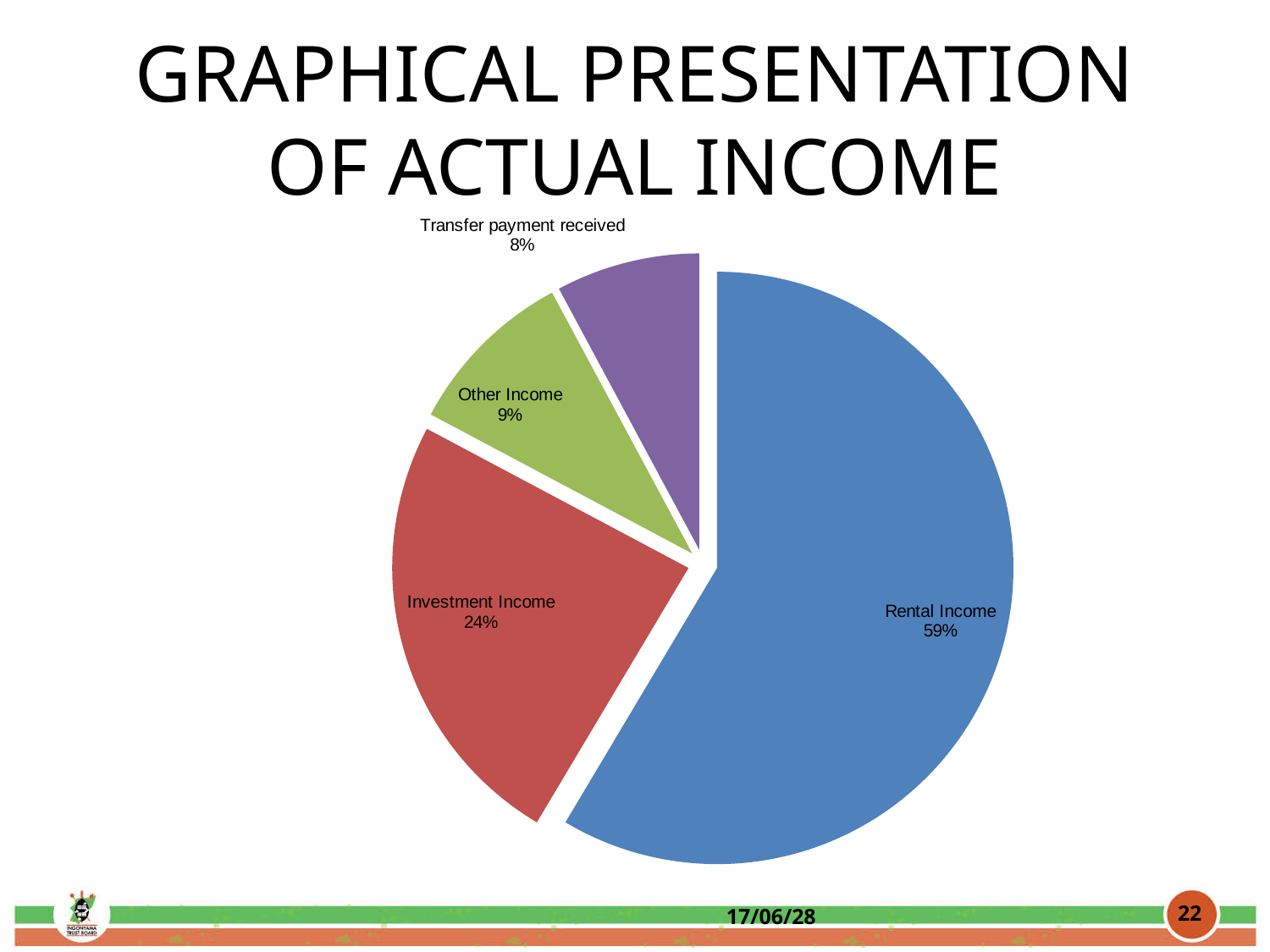
What kind of chart is shown on the slide? Pie chart Which is larger, Investment Income or Other Income? Investment Income What is the difference in percentage points between Rental Income and Investment Income? 35 What share of actual income does Rental Income represent? 59% Which income category has the smallest slice of the pie? Transfer payment received What is the value shown for Other Income? 9% How many categories are shown in the pie chart? 4 What percentage of the pie is Investment Income? 24% Which income category has the largest slice of the pie? Rental Income What percentage is labelled for Transfer payment received? 8% What is the combined percentage of Other Income and Transfer payment received? 17% What colour is the Rental Income slice? Blue